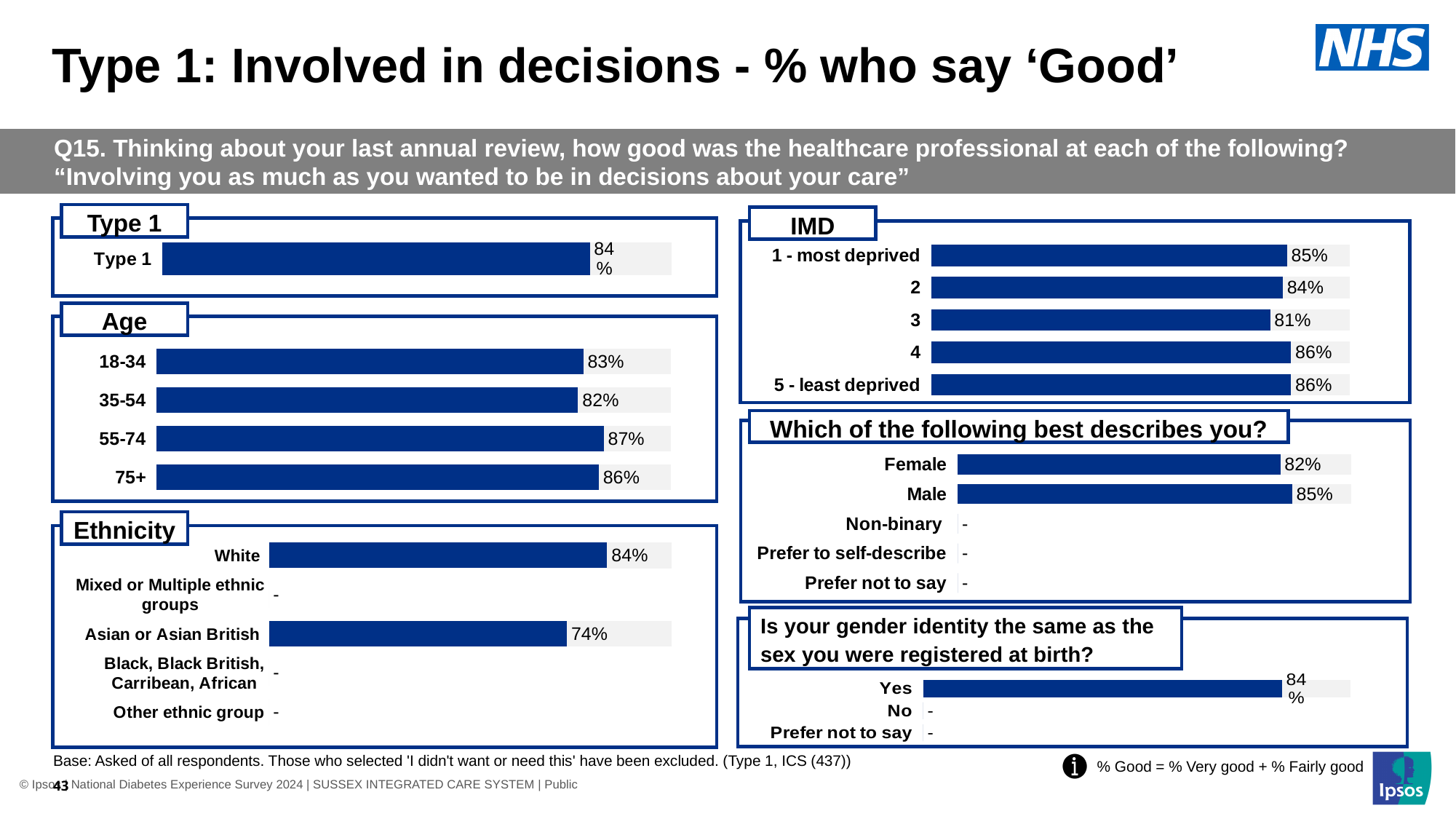
In the IMD chart, how many categories are shown? 5 In the Ethnicity chart, what is the value for Asian or Asian British? 74% In the Age chart, what is the difference between the values for 55-74 and 18-34? 4 percentage points In the Ethnicity chart, what is the difference between the values for White and Asian or Asian British? 10 percentage points In the Age chart, which age group has the lowest value? 35-54 In the Age chart, what is the value for the 55-74 age group? 87% In the 'Which of the following best describes you?' chart, which is larger, the value for Female or Male? Male What type of chart is used in the Age section? Bar chart In the IMD chart, which category has the lowest value? 3 In the 'Is your gender identity the same as the sex you were registered at birth?' chart, what is the value for Yes? 84% In the IMD chart, what is the value for 3? 81% In the 'Which of the following best describes you?' chart, what is the value for Female? 82%